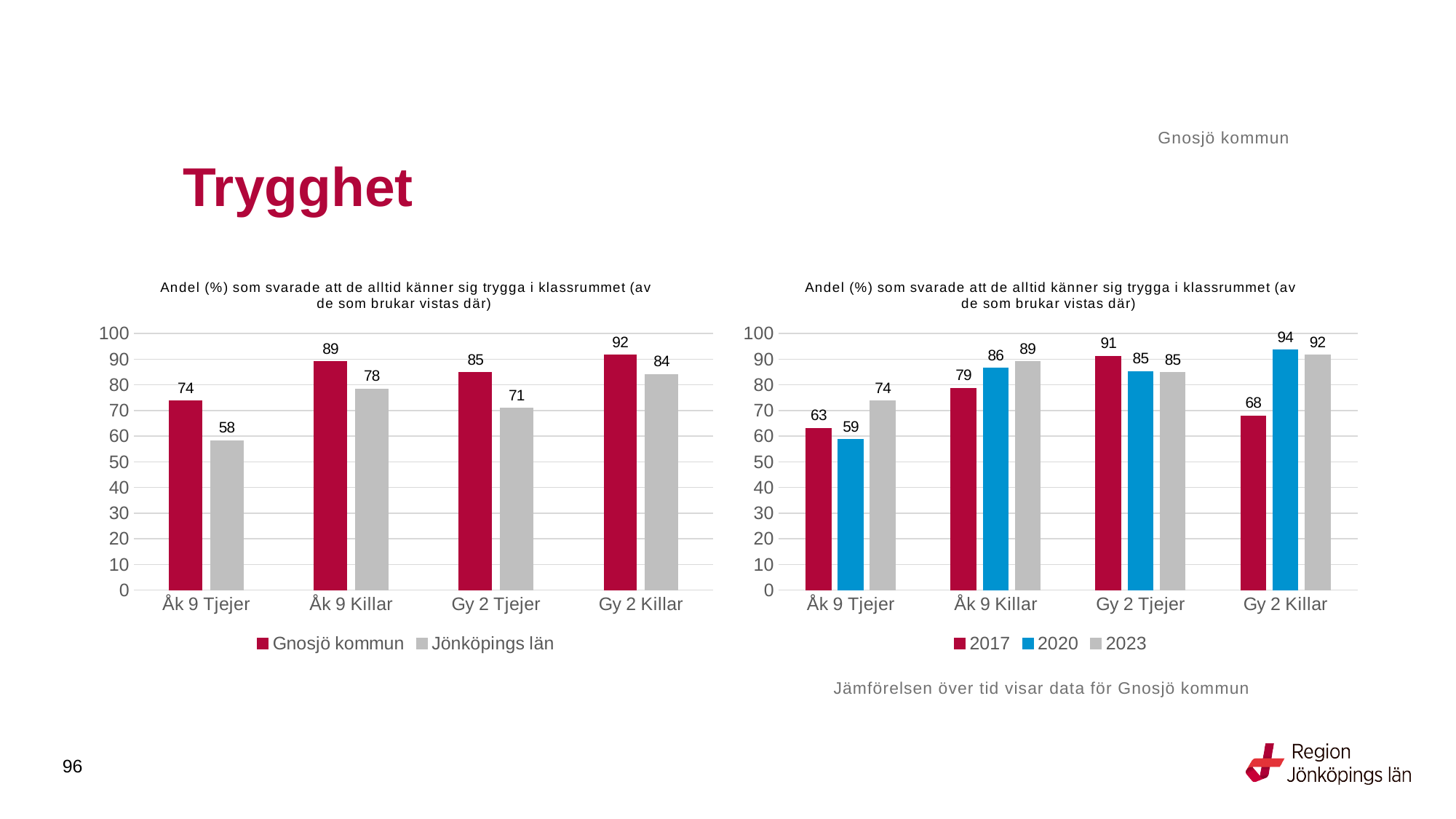
What kind of chart is the right chart? Bar chart In the right chart, which is larger for Åk 9 Tjejer: 2017 or 2023? 2023 In the right chart, what is the value for 2017 for Åk 9 Killar? 79 In the left chart, what is the value for Gnosjö kommun for Åk 9 Tjejer? 74 In the left chart, which category has the lowest value for Jönköpings län? Åk 9 Tjejer In the right chart, what is the value for 2020 for Gy 2 Killar? 94 In the left chart, which category has the highest value for Gnosjö kommun? Gy 2 Killar In the right chart, how many categories are shown on the x axis? 4 In the right chart, what is the difference between 2017 and 2023 for Gy 2 Killar? 24 In the left chart, how many series does the legend list? 2 In the left chart, what is the difference between Gnosjö kommun and Jönköpings län for Åk 9 Tjejer? 16 In the left chart, what is the value for Jönköpings län for Gy 2 Tjejer? 71